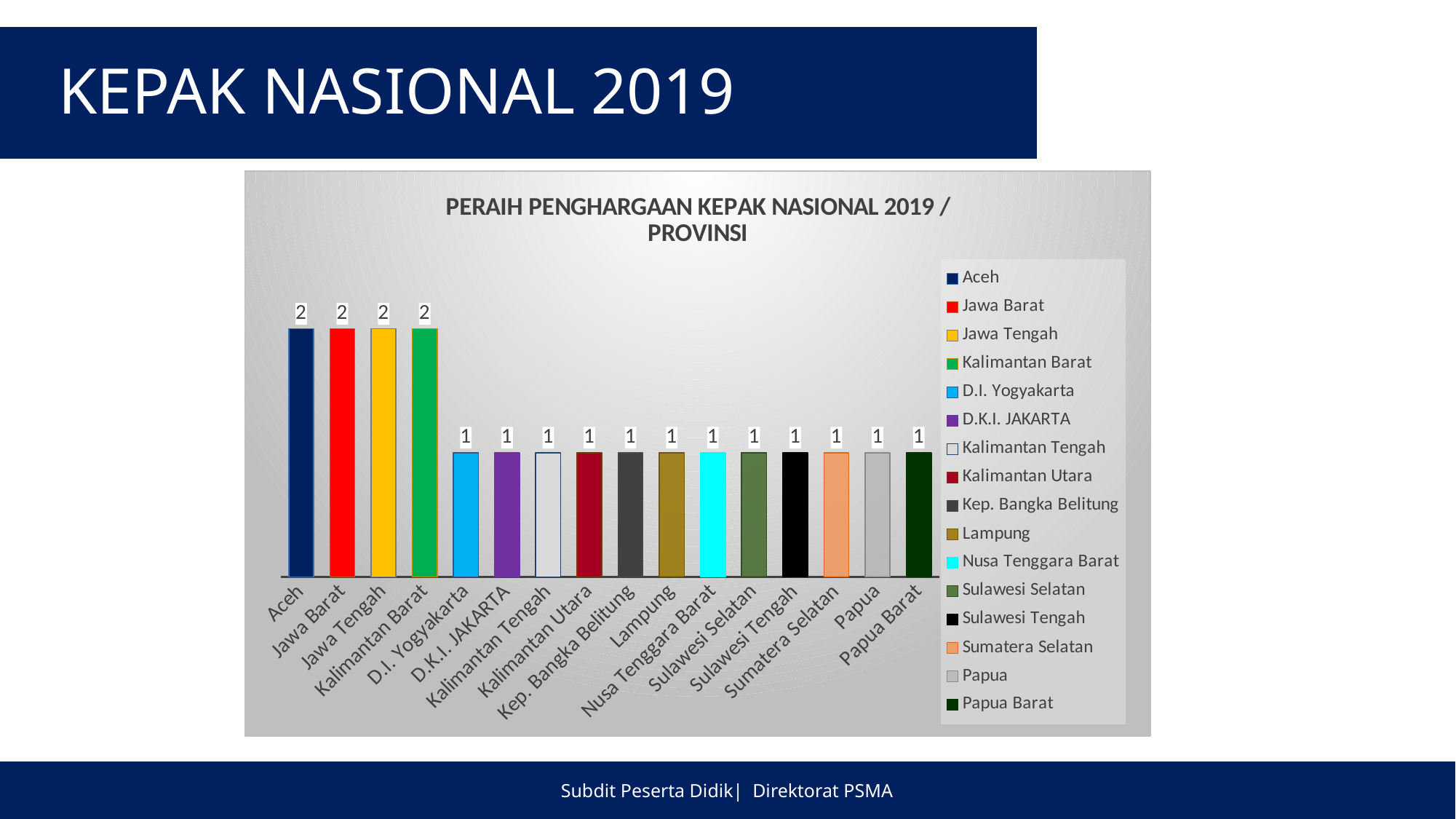
What is the value for Papua Barat? 1 What is the title of the chart? PERAIH PENGHARGAAN KEPAK NASIONAL 2019 / PROVINSI Which is larger, the value for Jawa Tengah or the value for Sulawesi Selatan? Jawa Tengah What is the value for Lampung? 1 How many provinces have a value of 2? 4 What is the value for Kalimantan Barat? 2 What is the value for Aceh? 2 How many provinces are shown on the x axis? 16 How many entries does the legend list? 16 What is the difference between the value for Jawa Barat and the value for Papua? 1 What colour is the bar for Jawa Barat? red What kind of chart is shown? bar chart